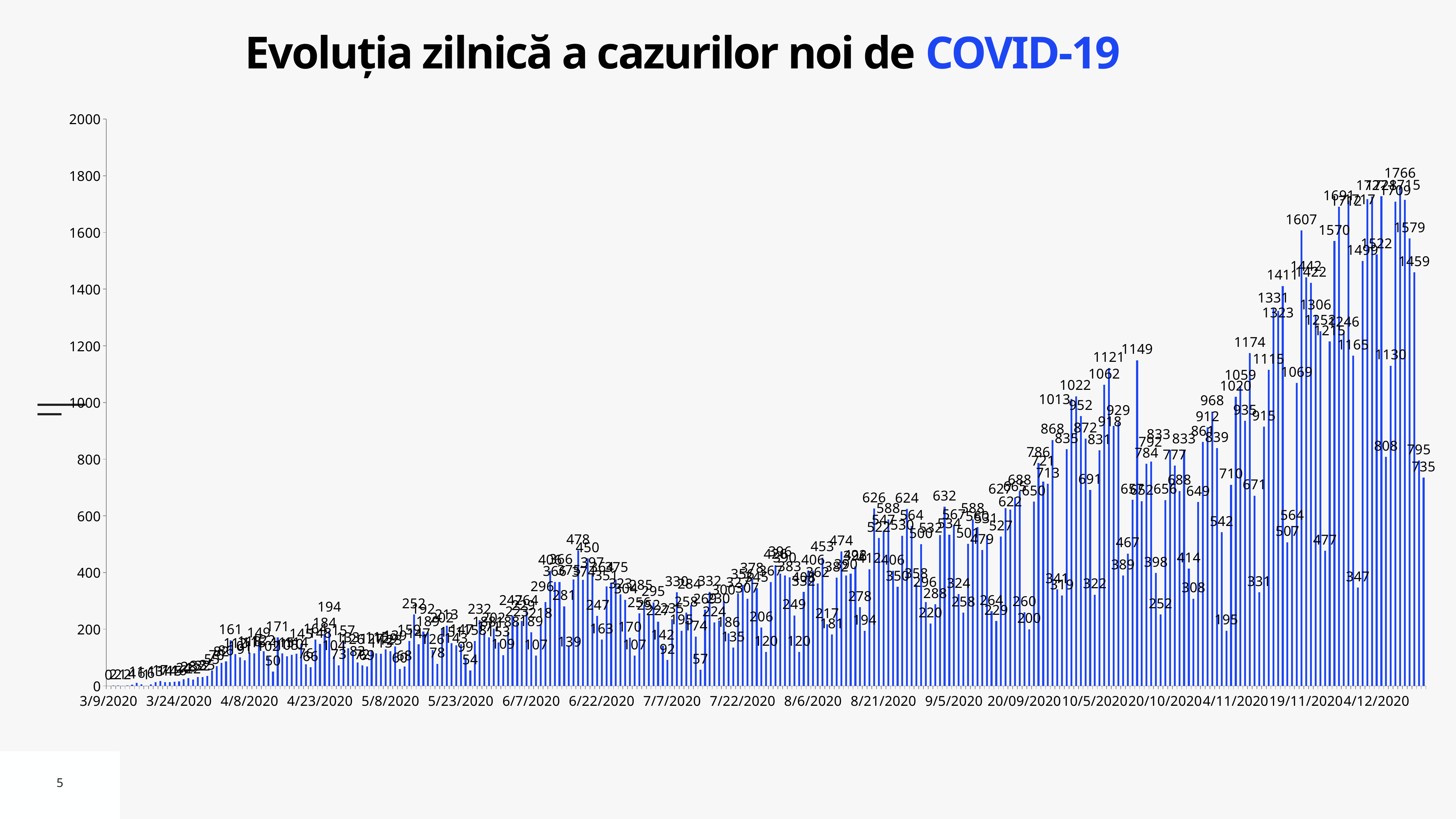
Is the highest bar on the chart greater or less than 1600? greater Is the highest bar on the chart greater or less than 1800? less What is the lowest value labeled on the chart, at the start of the series? 0 Are the bars in the first half of March 2020 greater or less than 200? less Overall, do the daily values rise or fall from March 2020 to December 2020? rise What is the highest daily value labeled on the chart? 1766 What is the maximum value shown on the vertical axis? 2000 What is the title of the chart? Evoluția zilnică a cazurilor noi de COVID-19 What kind of chart is shown on the slide? bar chart Which labeled value is larger, 1766 or 1607? 1766 What is the difference between the labeled values 1766 and 1607? 159